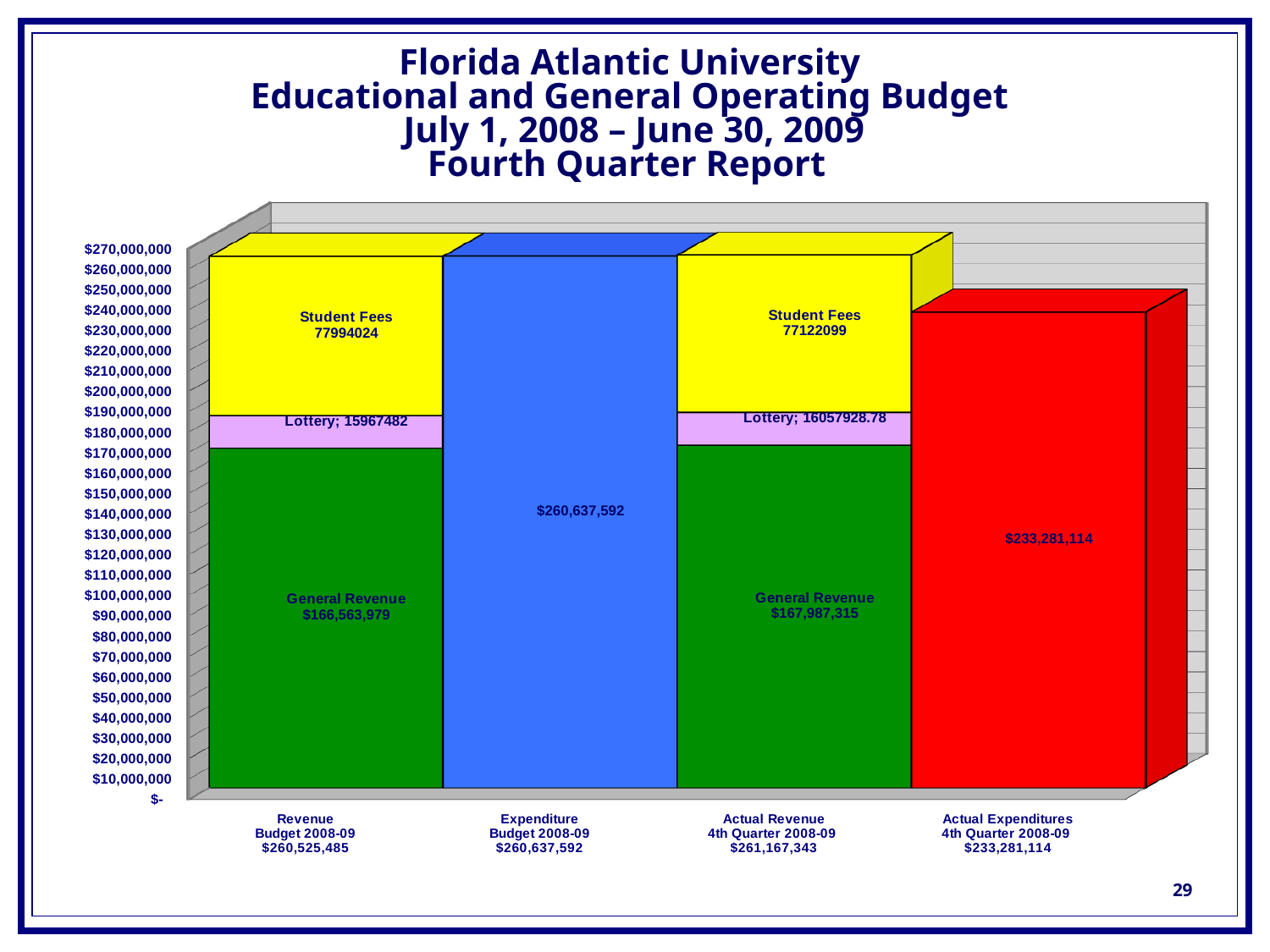
What is the General Revenue value in the Revenue Budget 2008-09 bar? $166,563,979 What is the value of the Expenditure Budget 2008-09 bar? $260,637,592 What is the total of the Revenue Budget 2008-09 stacked bar? $260,525,485 Is the value for Actual Expenditures 4th Quarter 2008-09 greater or less than $240,000,000? less What kind of chart is shown on the slide? bar chart What is the difference between the Expenditure Budget 2008-09 and the Actual Expenditures 4th Quarter 2008-09? $27,356,478 Which is larger, Actual Revenue 4th Quarter 2008-09 or Actual Expenditures 4th Quarter 2008-09? Actual Revenue 4th Quarter 2008-09 What is the difference between General Revenue in the Actual Revenue 4th Quarter 2008-09 bar and General Revenue in the Revenue Budget 2008-09 bar? $1,423,336 What is the Student Fees value in the Actual Revenue 4th Quarter 2008-09 bar? 77122099 What is the Lottery value in the Revenue Budget 2008-09 bar? 15967482 Which category has the lowest total value? Actual Expenditures 4th Quarter 2008-09 How many bars are shown in the chart? 4